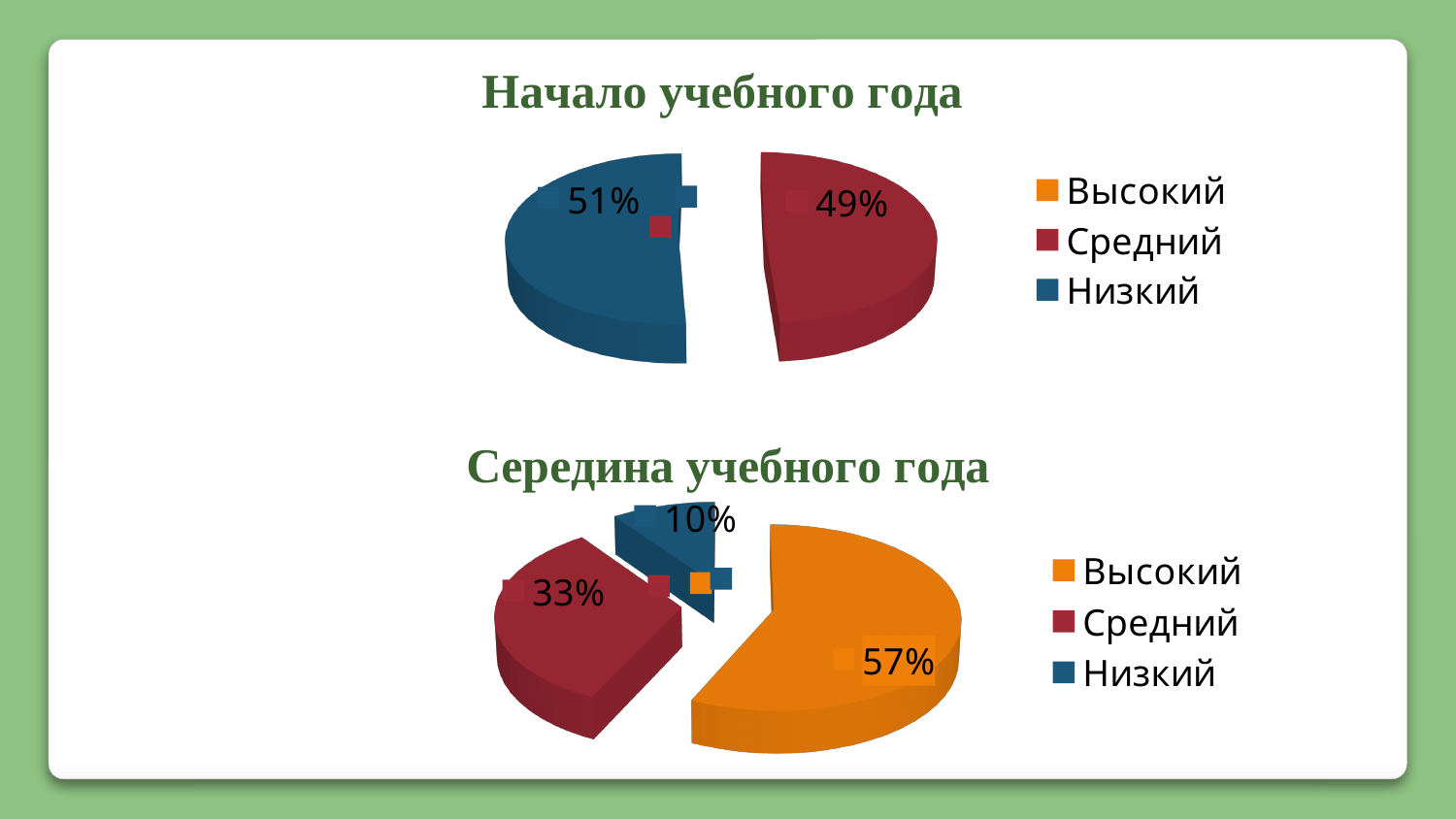
In the chart titled "Середина учебного года", what is the value for Низкий? 10% What kind of chart is the chart titled "Середина учебного года"? Pie chart In the chart titled "Начало учебного года", what is the value for Средний? 49% In the chart titled "Середина учебного года", what is the value for Высокий? 57% In the chart titled "Середина учебного года", how many slices are labelled with values? 3 In the chart titled "Середина учебного года", which category has the smallest slice? Низкий How many entries does the legend of the chart titled "Начало учебного года" list? 3 In the chart titled "Начало учебного года", what is the value for Низкий? 51% In the chart titled "Середина учебного года", what is the difference between the values for Высокий and Средний? 24% In the chart titled "Середина учебного года", which category has the largest slice? Высокий In the chart titled "Середина учебного года", what colour is the Высокий slice? Orange In the chart titled "Начало учебного года", which is larger, Низкий or Средний? Низкий